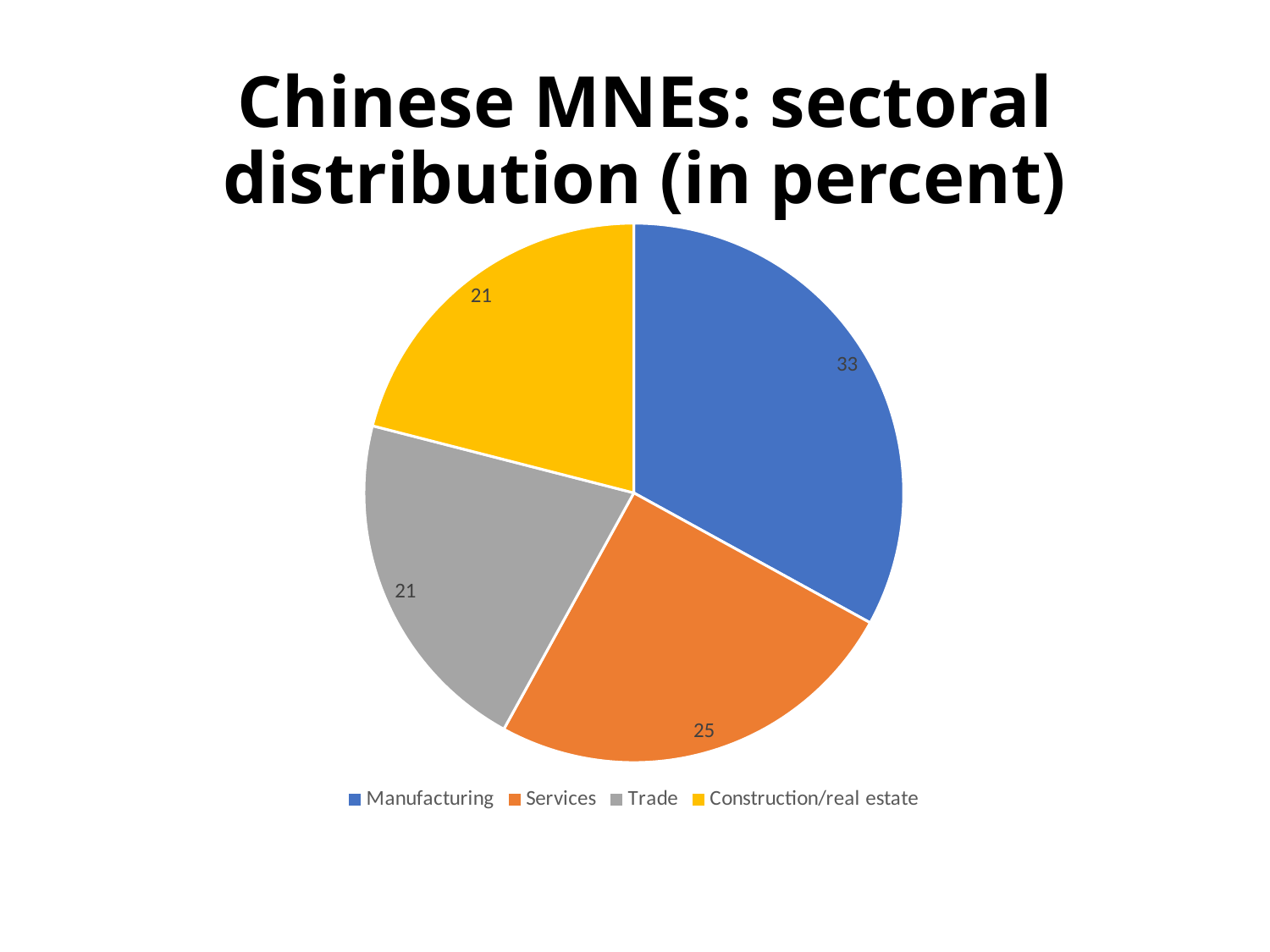
What is the value for Services? 25 Which colour represents Trade in the legend? Grey Which sector has the largest slice? Manufacturing What is the title of the chart? Chinese MNEs: sectoral distribution (in percent) What is the value for Construction/real estate? 21 What kind of chart is shown on the slide? Pie chart What is the value for Trade? 21 How many slices does the pie chart have? 4 What is the difference between the Services and Trade values? 4 What is the value for Manufacturing? 33 What is the difference between the Manufacturing and Services values? 8 Which is larger, Manufacturing or Services? Manufacturing